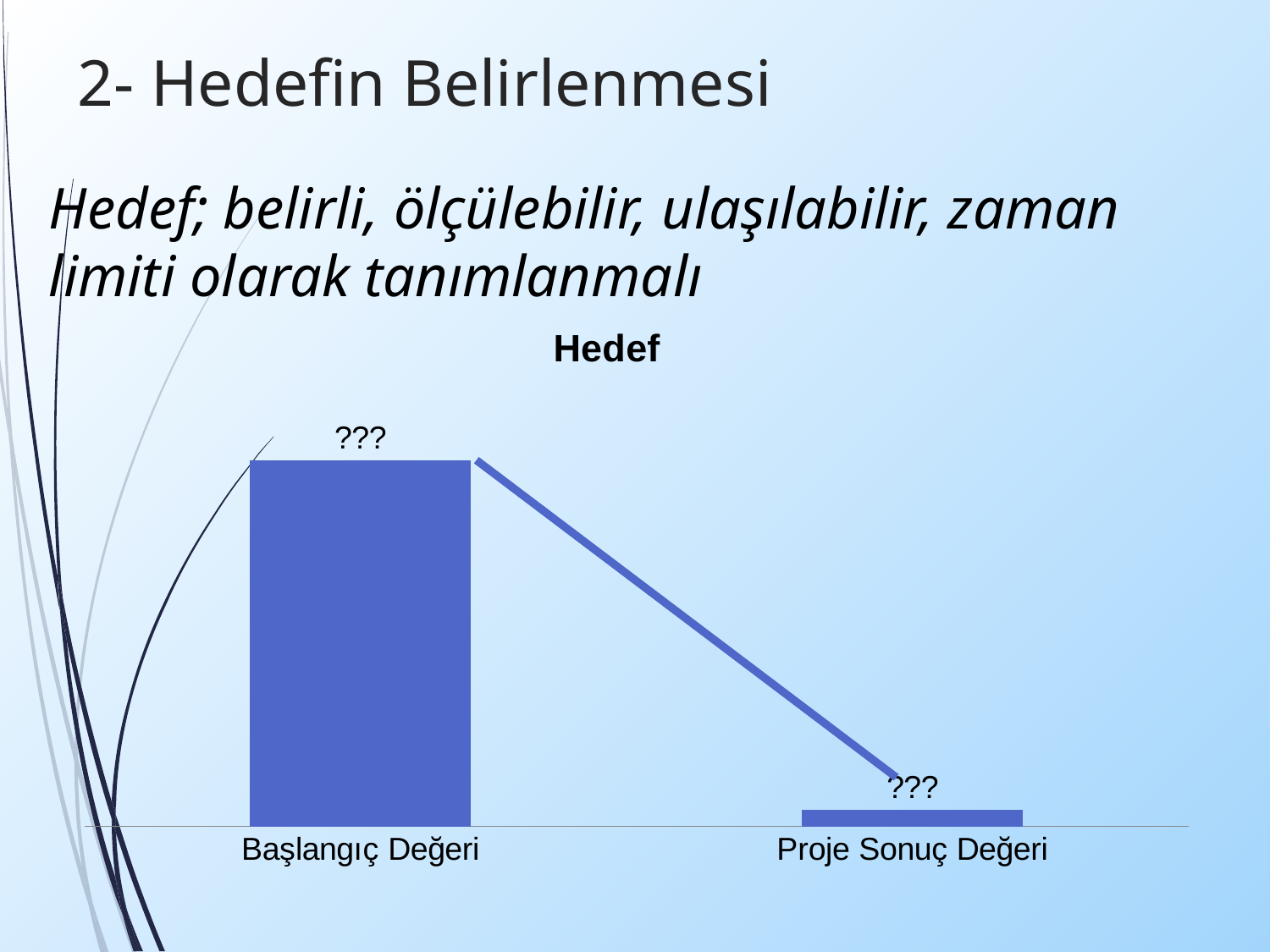
What kind of chart is shown on the slide? bar chart What is the title of the chart? Hedef How many categories are shown on the chart? 2 Which category has the lowest bar? Proje Sonuç Değeri Which category has the highest bar? Başlangıç Değeri Which is larger, the bar for Başlangıç Değeri or the bar for Proje Sonuç Değeri? Başlangıç Değeri What text is shown as the data label above each bar? ??? Do the values rise or fall from Başlangıç Değeri to Proje Sonuç Değeri? fall